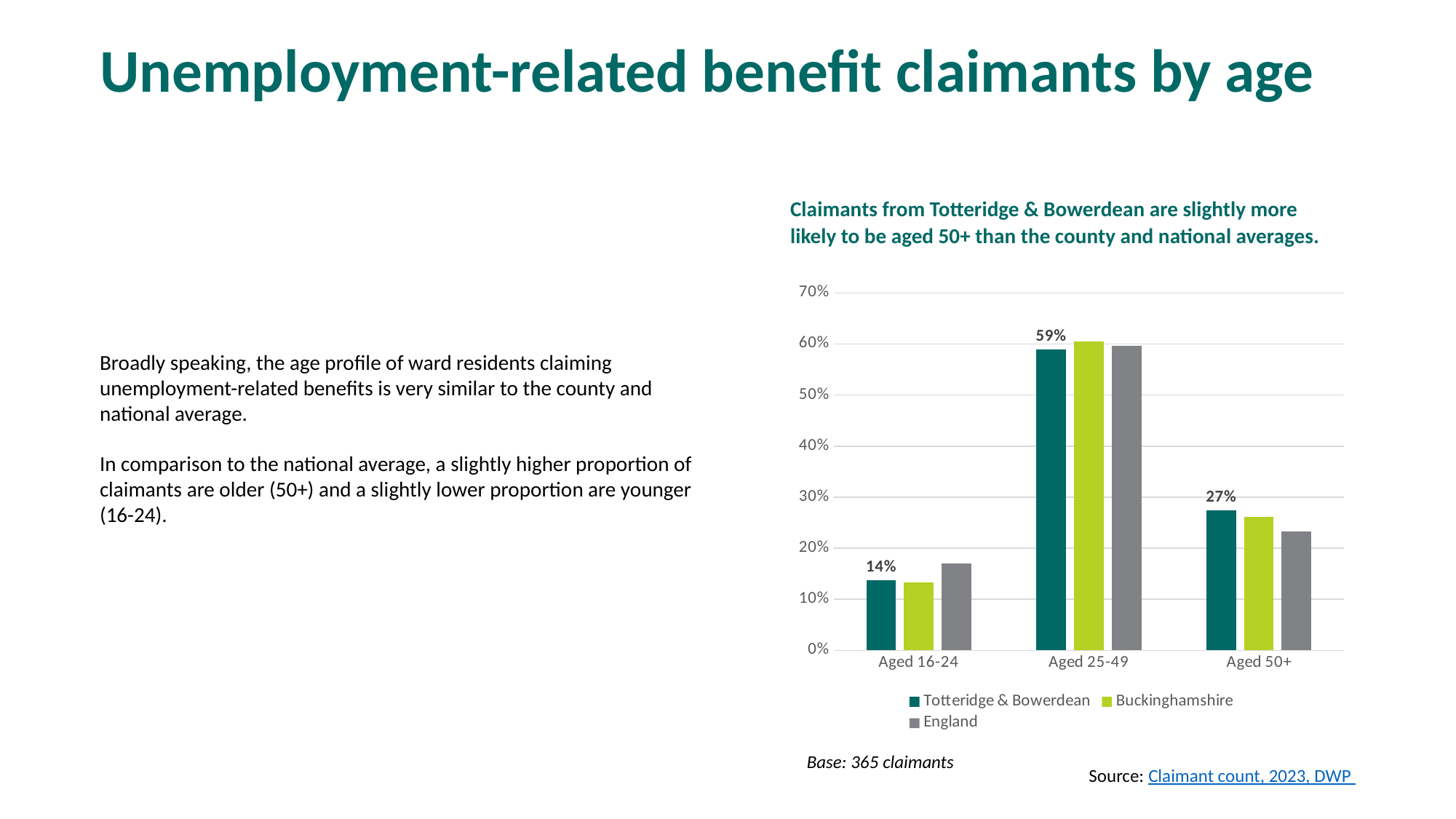
Is the value for England in the Aged 16-24 category greater or less than 20%? less How many age categories are shown on the x axis? 3 Which age category has the highest value for Totteridge & Bowerdean? Aged 25-49 Is the value for Buckinghamshire in the Aged 50+ category greater or less than 30%? less What is the value for Totteridge & Bowerdean in the Aged 16-24 category? 14% Which age category has the lowest value for Totteridge & Bowerdean? Aged 16-24 In the Aged 16-24 category, which is larger: England or Totteridge & Bowerdean? England What is the value for Totteridge & Bowerdean in the Aged 50+ category? 27% What is the difference between the Totteridge & Bowerdean values for Aged 25-49 and Aged 16-24? 45 percentage points In the Aged 50+ category, which is larger: Totteridge & Bowerdean or England? Totteridge & Bowerdean How many series does the legend list? 3 What is the value for Totteridge & Bowerdean in the Aged 25-49 category? 59%